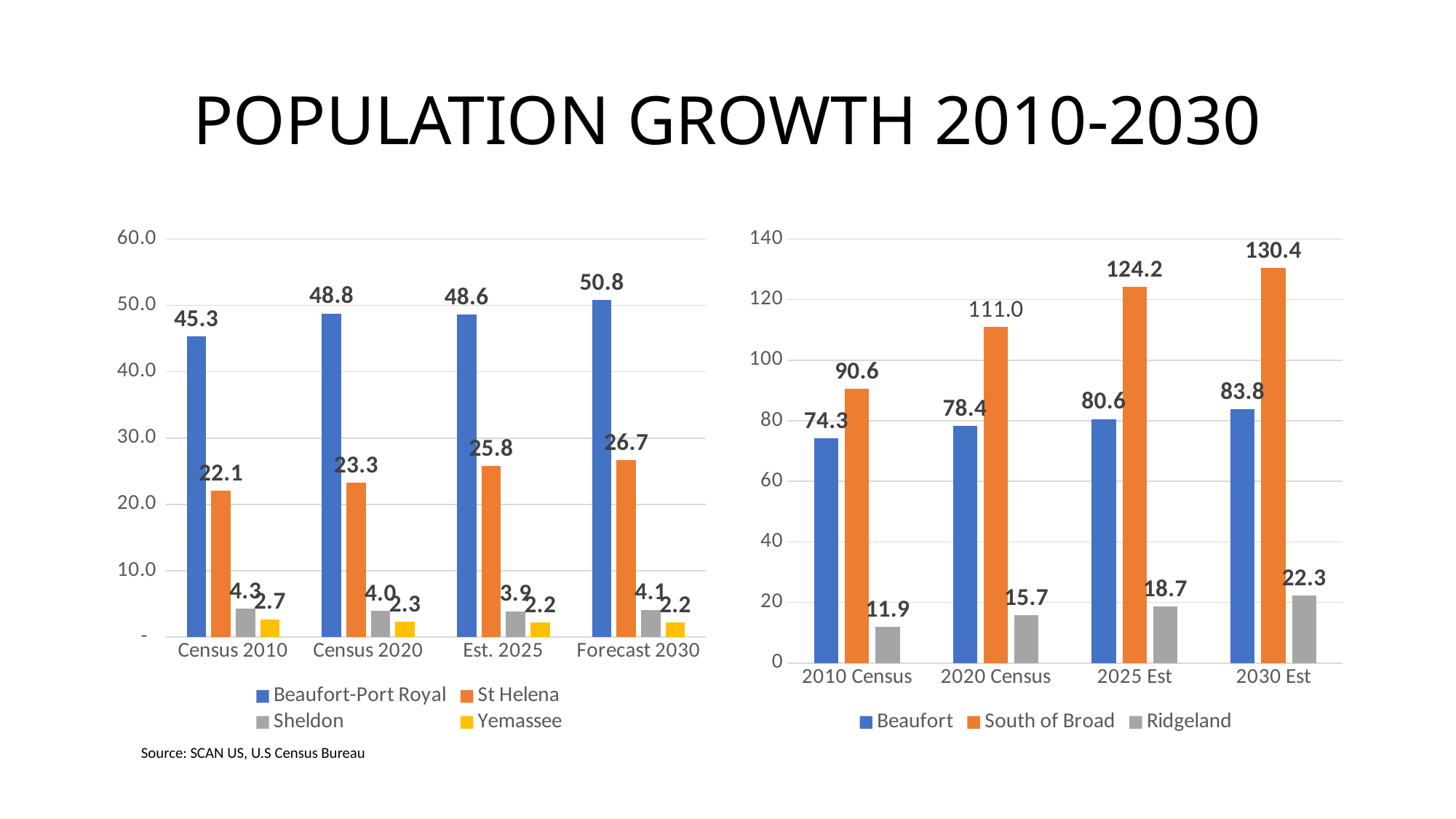
How many series does the legend of the left chart list? 4 In the right chart, which series has the highest value in 2020 Census? South of Broad How many categories are shown on the x axis of the right chart? 4 In the left chart, what is the value for Beaufort-Port Royal in Census 2010? 45.3 In the right chart, is the value for Beaufort in 2010 Census larger or smaller than the value for South of Broad in 2010 Census? smaller In the right chart, what is the value for South of Broad in 2030 Est? 130.4 In the right chart, what is the value for Ridgeland in 2010 Census? 11.9 In the left chart, which series has the lowest value in Est. 2025? Yemassee In the left chart, what is the value for St Helena in Forecast 2030? 26.7 In the right chart, do the values for South of Broad rise or fall from 2010 Census to 2030 Est? rise In the right chart, what is the difference between South of Broad and Beaufort in 2025 Est? 43.6 In the left chart, what is the difference between Beaufort-Port Royal in Forecast 2030 and in Census 2010? 5.5